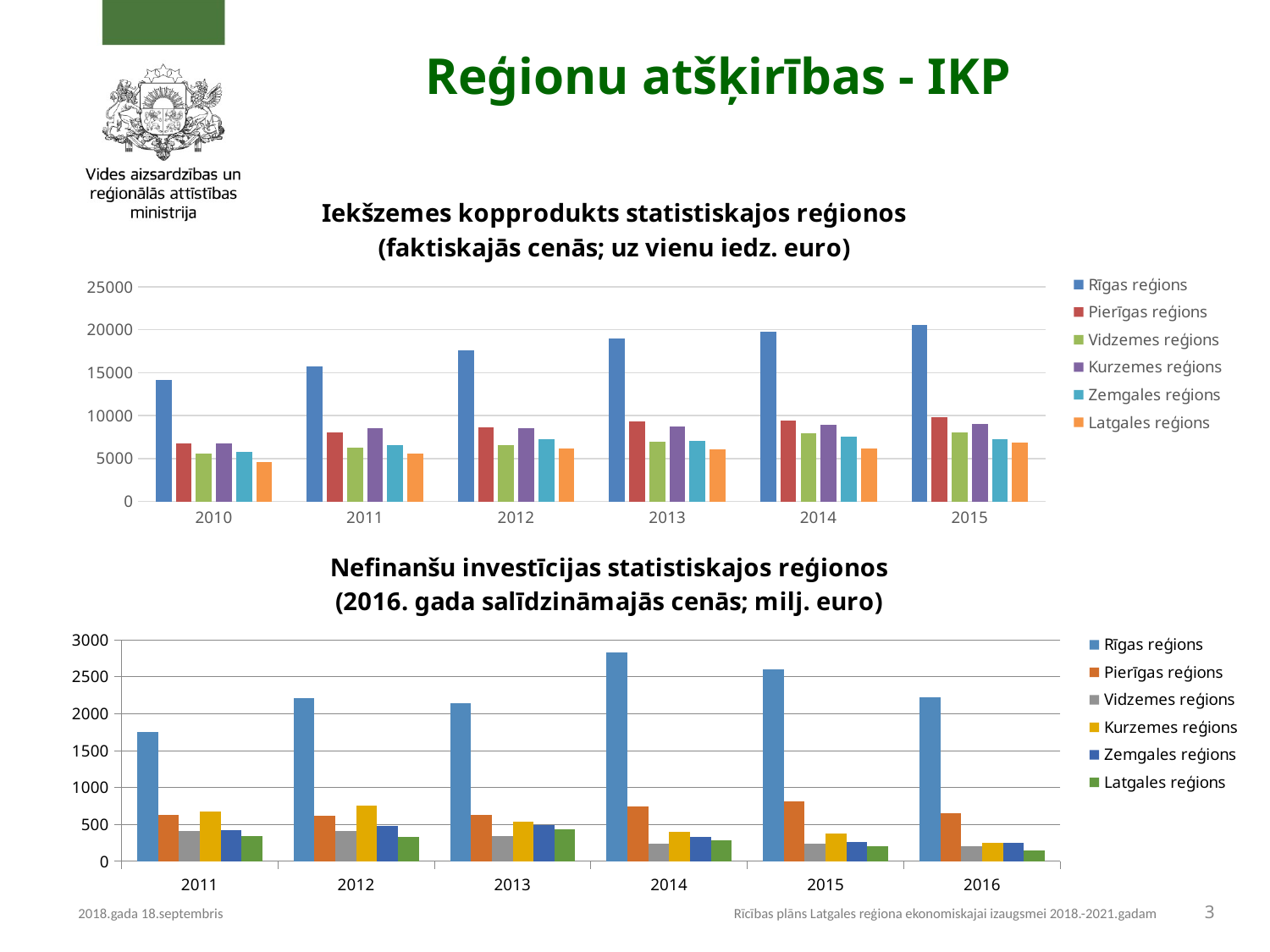
What type of chart is the top chart, 'Iekšzemes kopprodukts statistiskajos reģionos'? bar chart In the top chart 'Iekšzemes kopprodukts statistiskajos reģionos', which region has the highest value in 2015? Rīgas reģions How many years are shown on the x axis of the top chart 'Iekšzemes kopprodukts statistiskajos reģionos'? 6 In the bottom chart 'Nefinanšu investīcijas statistiskajos reģionos', which is larger in 2016: Rīgas reģions or Pierīgas reģions? Rīgas reģions In the top chart 'Iekšzemes kopprodukts statistiskajos reģionos', is the value for Rīgas reģions in 2010 greater or less than 15000? less In the bottom chart 'Nefinanšu investīcijas statistiskajos reģionos', is the value for Rīgas reģions in 2014 greater or less than 2500? greater In the top chart 'Iekšzemes kopprodukts statistiskajos reģionos', does the value for Rīgas reģions rise or fall from 2010 to 2015? rise In the top chart 'Iekšzemes kopprodukts statistiskajos reģionos', is the value for Rīgas reģions in 2015 greater or less than 20000? greater How many series does the legend of the top chart 'Iekšzemes kopprodukts statistiskajos reģionos' list? 6 How many years are shown on the x axis of the bottom chart 'Nefinanšu investīcijas statistiskajos reģionos'? 6 In the bottom chart 'Nefinanšu investīcijas statistiskajos reģionos', in which year is the value for Rīgas reģions highest? 2014 In the top chart 'Iekšzemes kopprodukts statistiskajos reģionos', which region has the lowest value in 2010? Latgales reģions